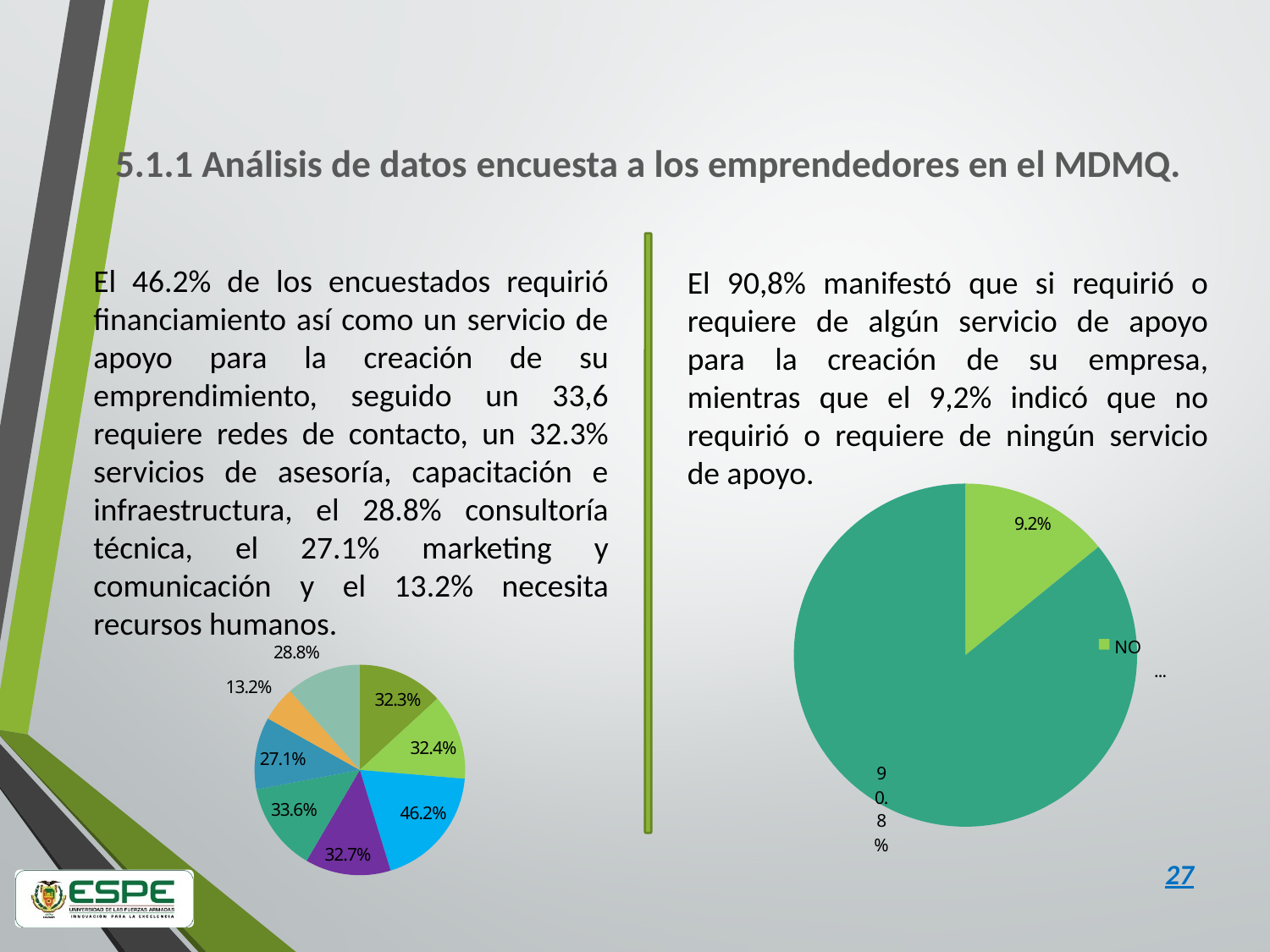
What kind of chart is the chart on the left side of the slide? pie chart In the pie chart on the left side of the slide, what is the value of the smallest slice? 13.2% In the pie chart on the left side of the slide, what colour is the largest slice (46.2%)? blue In the pie chart on the right side of the slide, what is the value of the largest slice? 90.8% In the pie chart on the left side of the slide, what is the value of the largest slice? 46.2% In the pie chart on the left side of the slide, what is the difference between the 46.2% slice and the 33.6% slice? 12.6% How many slices does the pie chart on the right side of the slide have? 2 In the pie chart on the left side of the slide, which slice is larger: the one labelled 32.7% or the one labelled 27.1%? 32.7% In the pie chart on the right side of the slide, is the NO slice larger or smaller than the other slice? smaller In the pie chart on the right side of the slide, what is the value of the NO slice? 9.2% How many slices does the pie chart on the left side of the slide have? 8 What kind of chart is the chart on the right side of the slide? pie chart